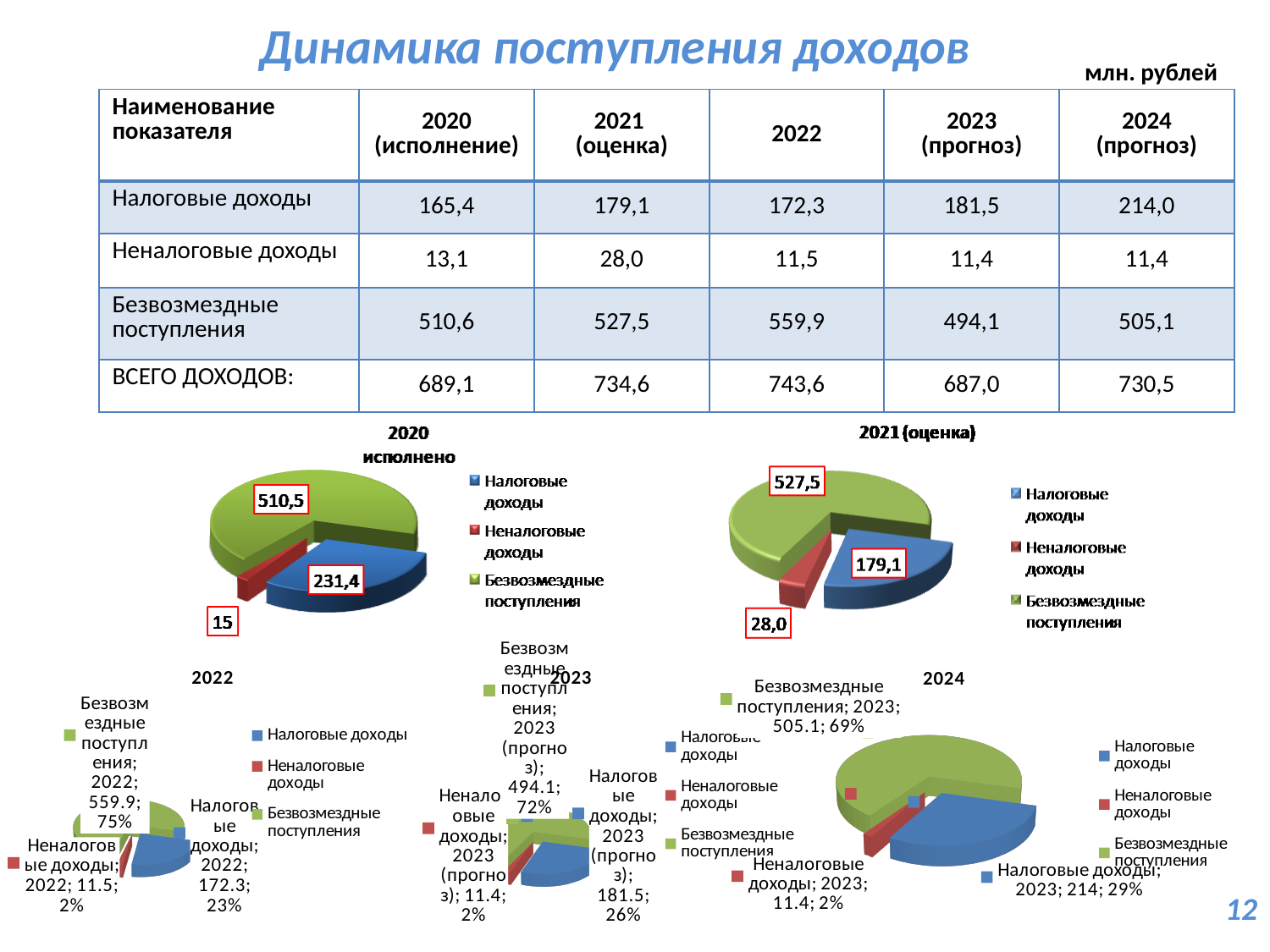
In the "2021 (оценка)" chart, which slice is the smallest? Неналоговые доходы In the "2023" chart, which slice is the largest? Безвозмездные поступления In the "2024" chart, what value is labelled for Налоговые доходы? 214 How many pie charts are shown on the slide? 5 How many entries does the legend of the "2021 (оценка)" chart list? 3 In the "2023" chart, what share of the pie is Налоговые доходы? 26% What kind of chart is the "2020 исполнено" chart? pie chart In the "2021 (оценка)" chart, what is the difference between the labelled values for Безвозмездные поступления and Налоговые доходы? 348,4 In the "2022" chart, what value is labelled for Налоговые доходы? 172.3 In the "2021 (оценка)" chart, what value is labelled for Налоговые доходы? 179,1 In the "2020 исполнено" chart, what value is labelled on the green slice (Безвозмездные поступления)? 510,5 In the "2022" chart, what share of the pie is Безвозмездные поступления? 75%